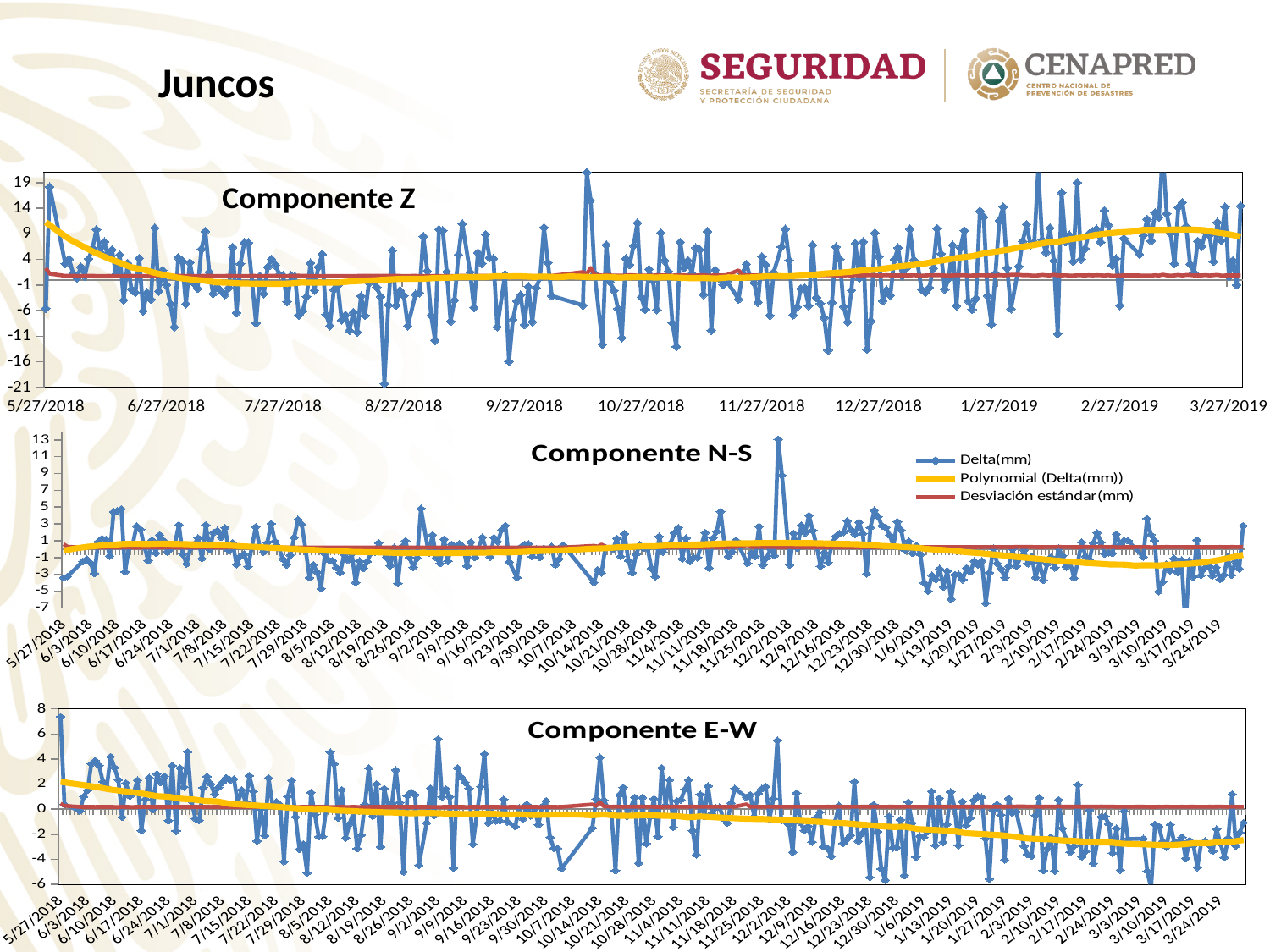
What kind of chart is the Componente Z chart? line chart How many series does the legend on the Componente N-S chart list? 3 In the Componente N-S chart, is the highest Delta(mm) spike, near 12/2/2018, greater or less than 11? greater In the Componente N-S chart, is the value of the yellow polynomial line at 3/3/2019 greater or less than 0? less In the Componente E-W chart, is the first Delta(mm) value at 5/27/2018 greater or less than 6? greater How many charts are shown on the slide? 3 What is the title of the bottom chart on the slide? Componente E-W In the Componente N-S chart, which series is drawn in yellow according to the legend? Polynomial (Delta(mm)) In the Componente E-W chart, does the yellow polynomial line rise or fall from 5/27/2018 to 3/24/2019? fall In the Componente Z chart, does the yellow polynomial line rise or fall between 12/27/2018 and 2/27/2019? rise